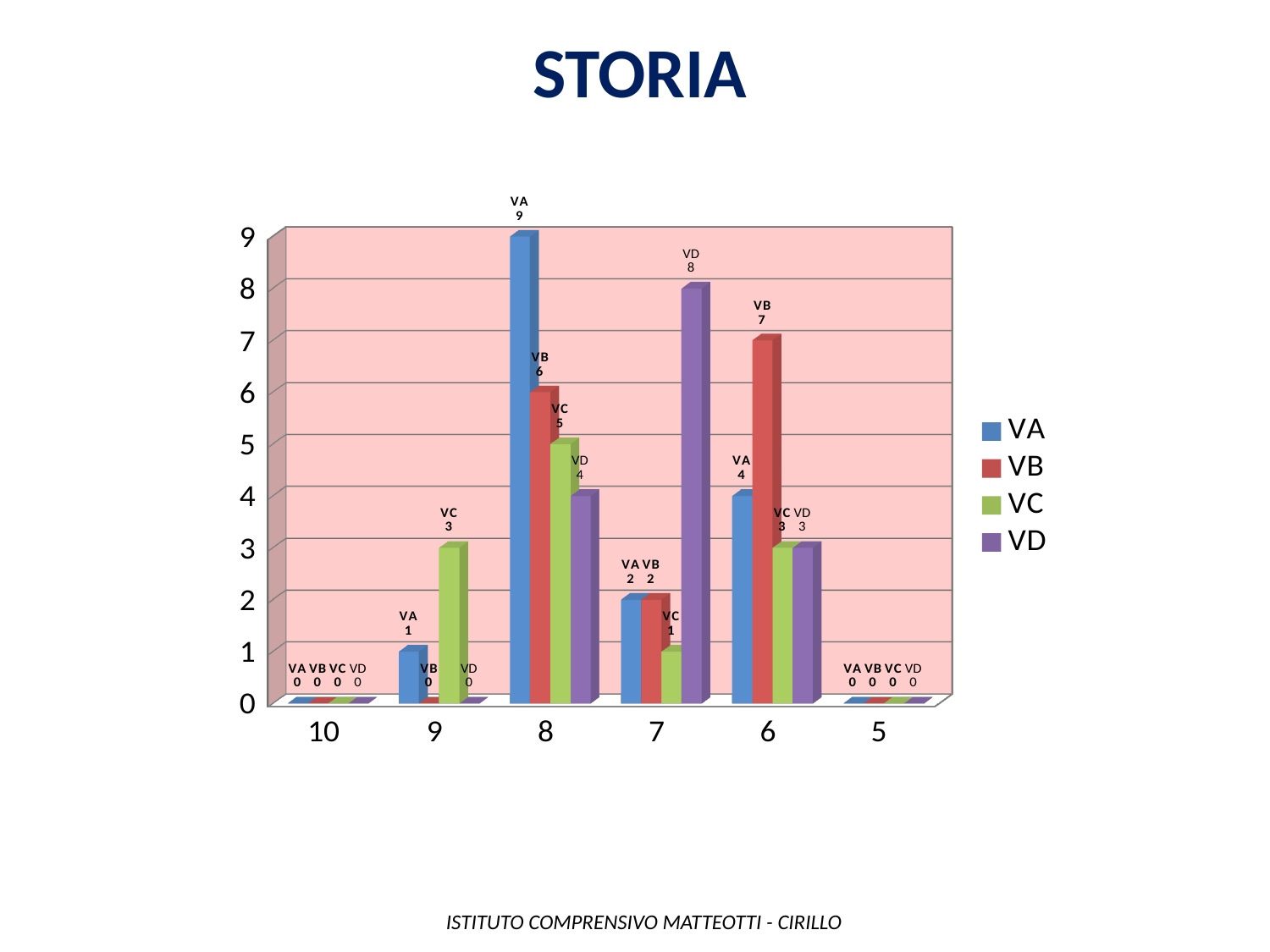
What is the title of the chart? STORIA How many categories are shown on the x axis? 6 What is the value for VD at category 7? 8 Which series has the highest value at category 8? VA What is the value for VB at category 6? 7 What is the value for VA at category 8? 9 What kind of chart is shown on the slide? bar chart Which series has the lowest value at category 7? VC Which is larger at category 6: the value for VB or the value for VA? VB What is the value for VC at category 9? 3 How many series does the legend list? 4 What is the difference between the VA and VD values at category 8? 5